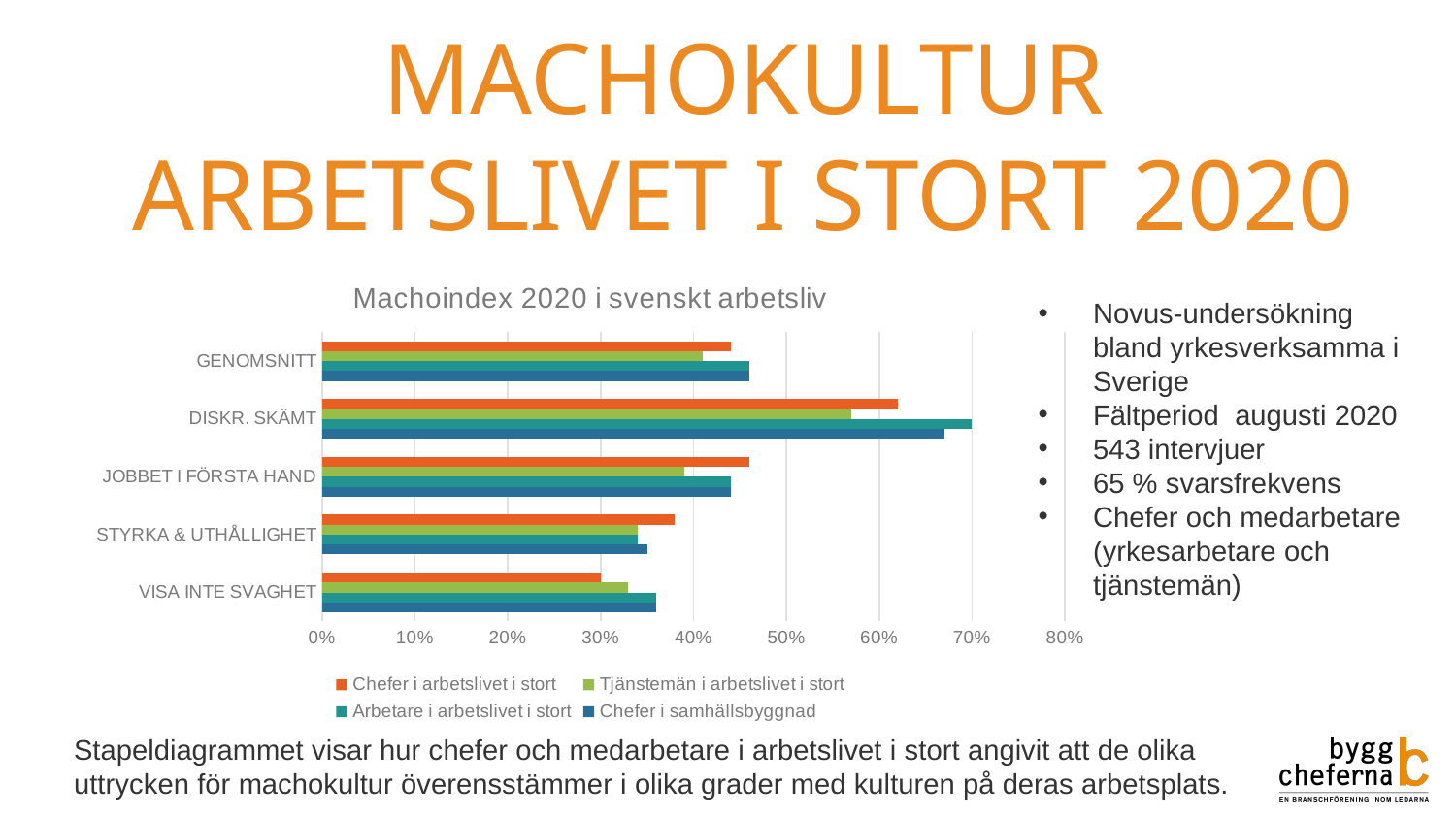
Is the value for STYRKA & UTHÅLLIGHET in the series Tjänstemän i arbetslivet i stort greater or less than 40%? less Which category has the highest value for the series Chefer i arbetslivet i stort? DISKR. SKÄMT What kind of chart is shown on the slide? Bar chart Is the value for DISKR. SKÄMT in the series Arbetare i arbetslivet i stort greater or less than 60%? greater For DISKR. SKÄMT, which is larger: the value for Arbetare i arbetslivet i stort or for Tjänstemän i arbetslivet i stort? Arbetare i arbetslivet i stort Is the value for VISA INTE SVAGHET in the series Chefer i arbetslivet i stort greater or less than 40%? less For JOBBET I FÖRSTA HAND, which is larger: the value for Chefer i arbetslivet i stort or for Tjänstemän i arbetslivet i stort? Chefer i arbetslivet i stort How many categories are shown on the chart's vertical axis? 5 Which category has the lowest value for the series Chefer i arbetslivet i stort? VISA INTE SVAGHET How many series does the chart's legend list? 4 What is the title of the chart? Machoindex 2020 i svenskt arbetsliv What is the highest value shown on the chart's horizontal axis? 80%